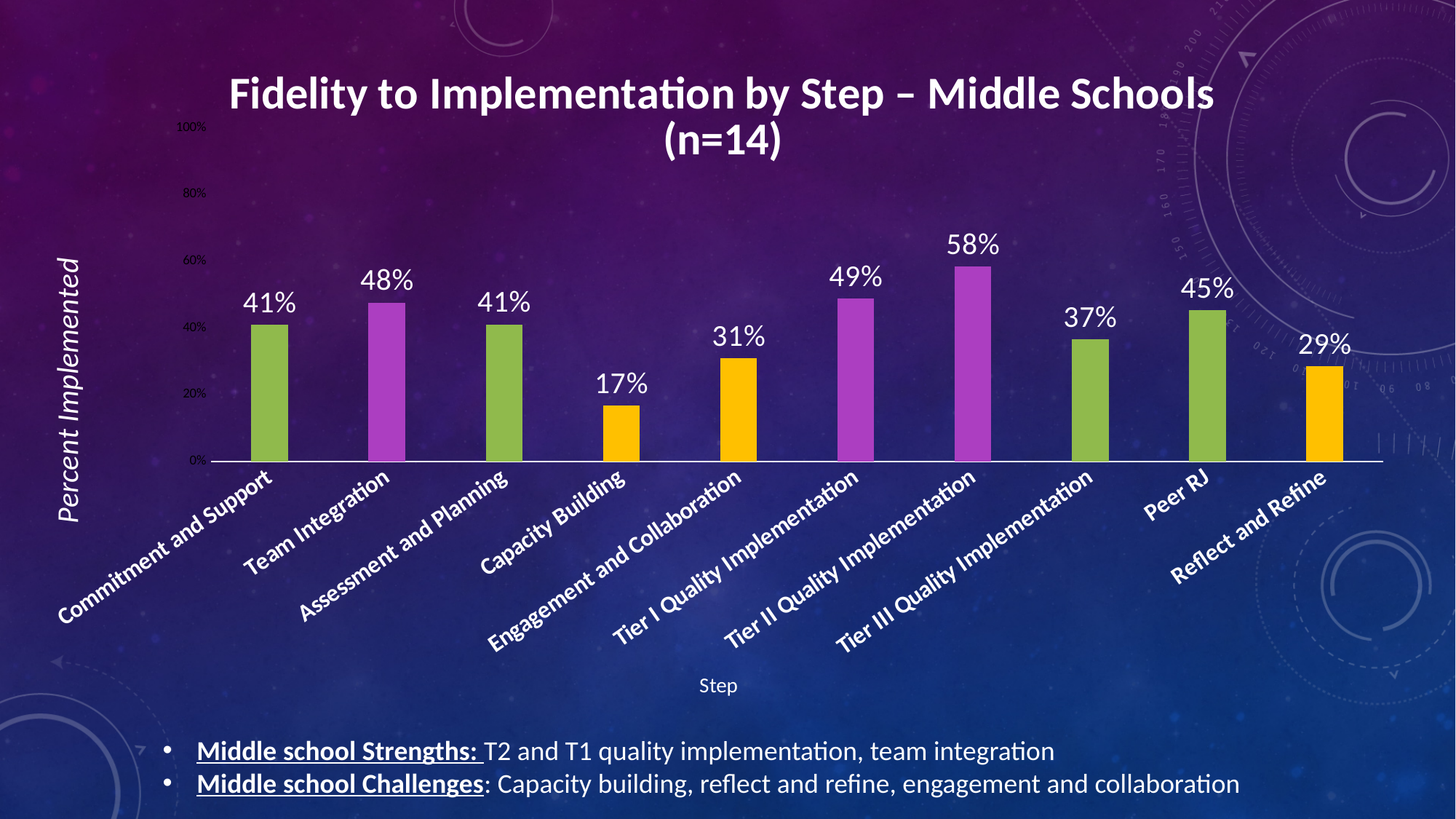
What is the difference between Tier II Quality Implementation and Reflect and Refine? 29% Is the value for Engagement and Collaboration greater or less than 40%? less What is the title of the chart? Fidelity to Implementation by Step – Middle Schools (n=14) What is the value for Peer RJ? 45% What is the label of the y axis? Percent Implemented Which step has the lowest percent implemented? Capacity Building What kind of chart is shown on the slide? bar chart What is the value for Capacity Building? 17% What is the value for Tier II Quality Implementation? 58% Which is larger, Team Integration or Tier III Quality Implementation? Team Integration Which step has the highest percent implemented? Tier II Quality Implementation How many steps are shown on the x axis? 10